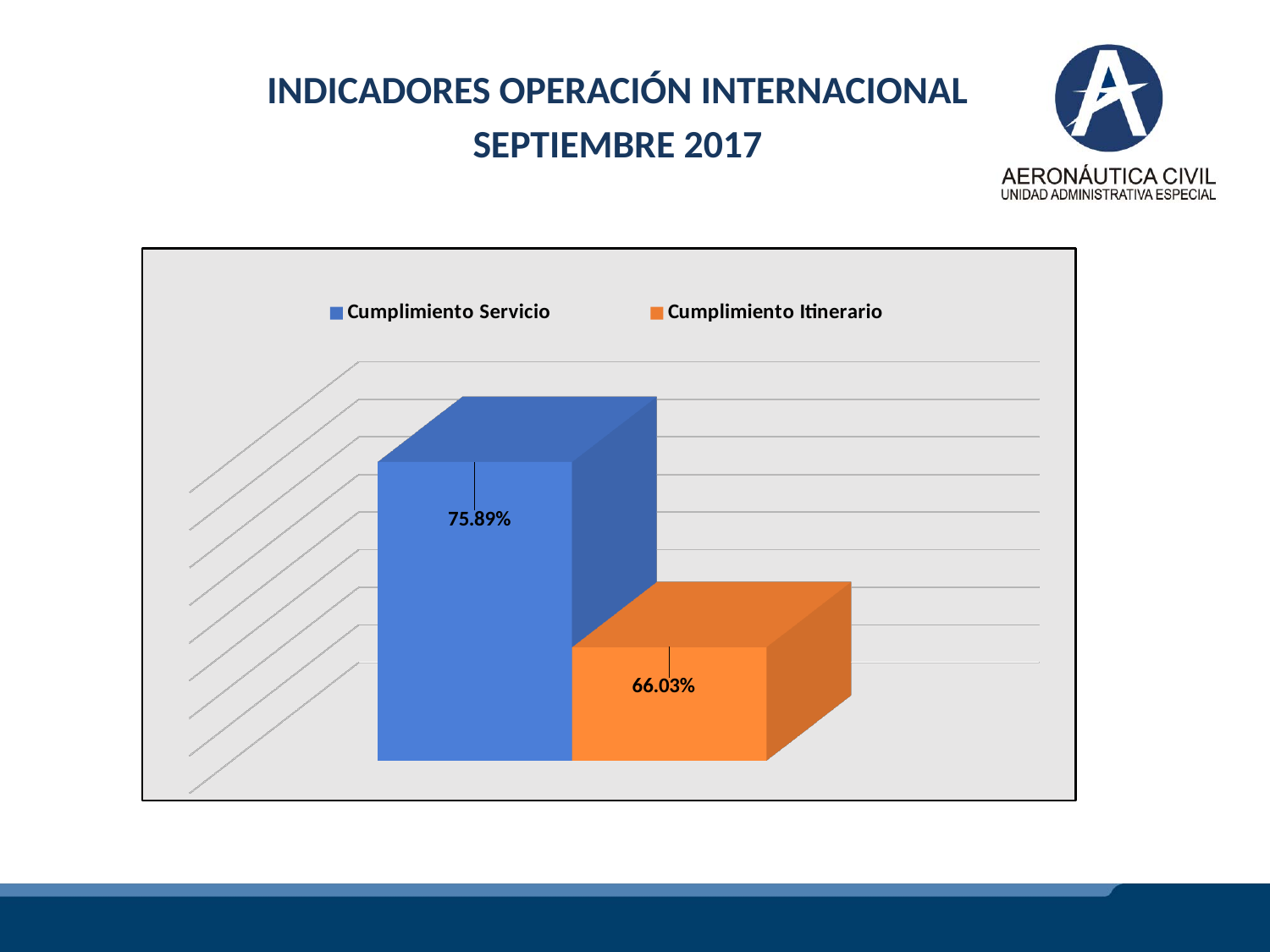
How many series does the legend list? 2 Which is larger, Cumplimiento Servicio or Cumplimiento Itinerario? Cumplimiento Servicio Which series has the lowest value? Cumplimiento Itinerario What is the value for Cumplimiento Itinerario? 66.03% Which series has the highest value? Cumplimiento Servicio What colour is the bar for Cumplimiento Itinerario? Orange How many bars are plotted on the chart? 2 What kind of chart is shown on the slide? Bar chart What is the value for Cumplimiento Servicio? 75.89% What colour is the bar for Cumplimiento Servicio? Blue What is the difference between Cumplimiento Servicio and Cumplimiento Itinerario? 9.86%